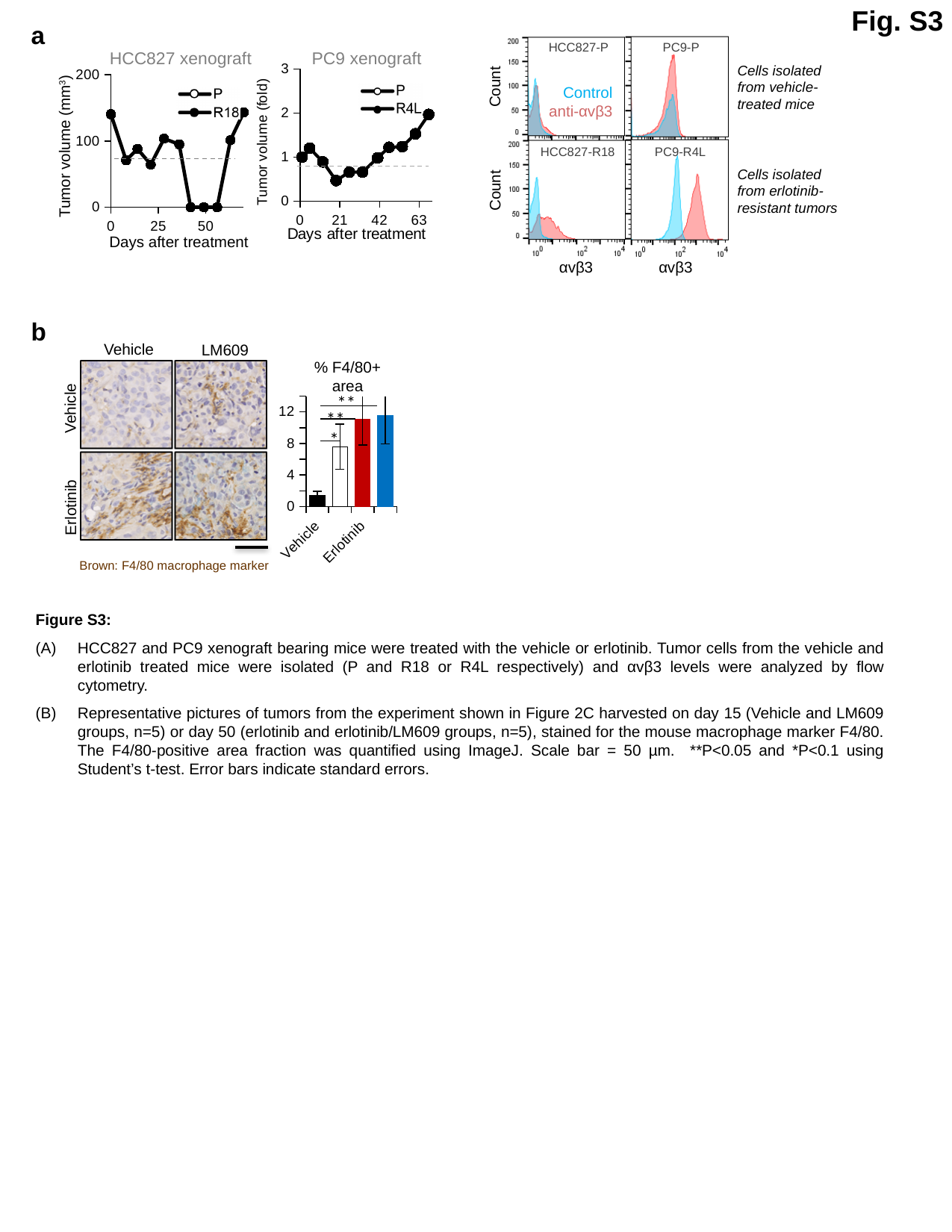
What kind of chart is the HCC827 xenograft chart? line chart In the PC9 xenograft chart, do the values rise or fall from day 21 to the end of the x axis? rise What are the two legend entries in the PC9 xenograft chart? P and R4L In the % F4/80+ area chart, is the Vehicle bar greater or less than 4? less In the PC9 xenograft chart, is the last plotted tumor volume greater or less than 1? greater What is the x-axis label of the flow cytometry histograms? αvβ3 In the PC9 xenograft chart, is the tumor volume at day 21 greater or less than 1? less What kind of chart is the % F4/80+ area chart? bar chart In the % F4/80+ area chart, which is larger, the Vehicle bar or the Erlotinib bar? Erlotinib How many series does the legend of the HCC827 xenograft chart list? 2 How many bars are plotted in the % F4/80+ area chart? 4